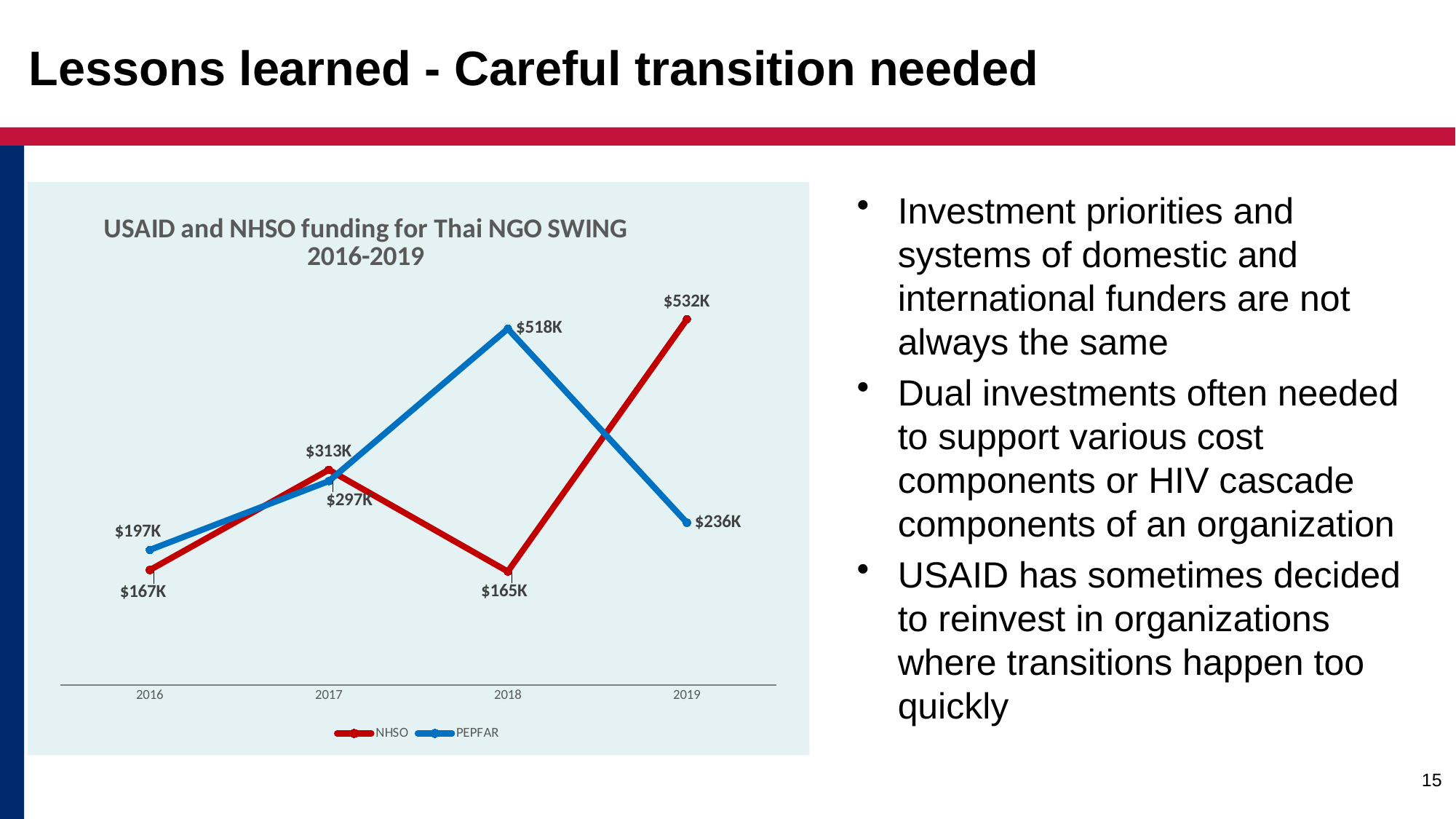
What is the PEPFAR funding value for 2019? $236K What type of chart is shown on the slide? Line chart Which series has the higher value in 2016, NHSO or PEPFAR? PEPFAR What is the title of the chart? USAID and NHSO funding for Thai NGO SWING 2016-2019 How many series does the legend list? 2 In which year is NHSO funding the lowest? 2018 What is the PEPFAR funding value for 2018? $518K What is the NHSO funding value for 2019? $532K What is the NHSO funding value for 2016? $167K How many years are shown on the x axis? 4 What is the difference between PEPFAR and NHSO funding in 2018? $353K In which year is PEPFAR funding the highest? 2018